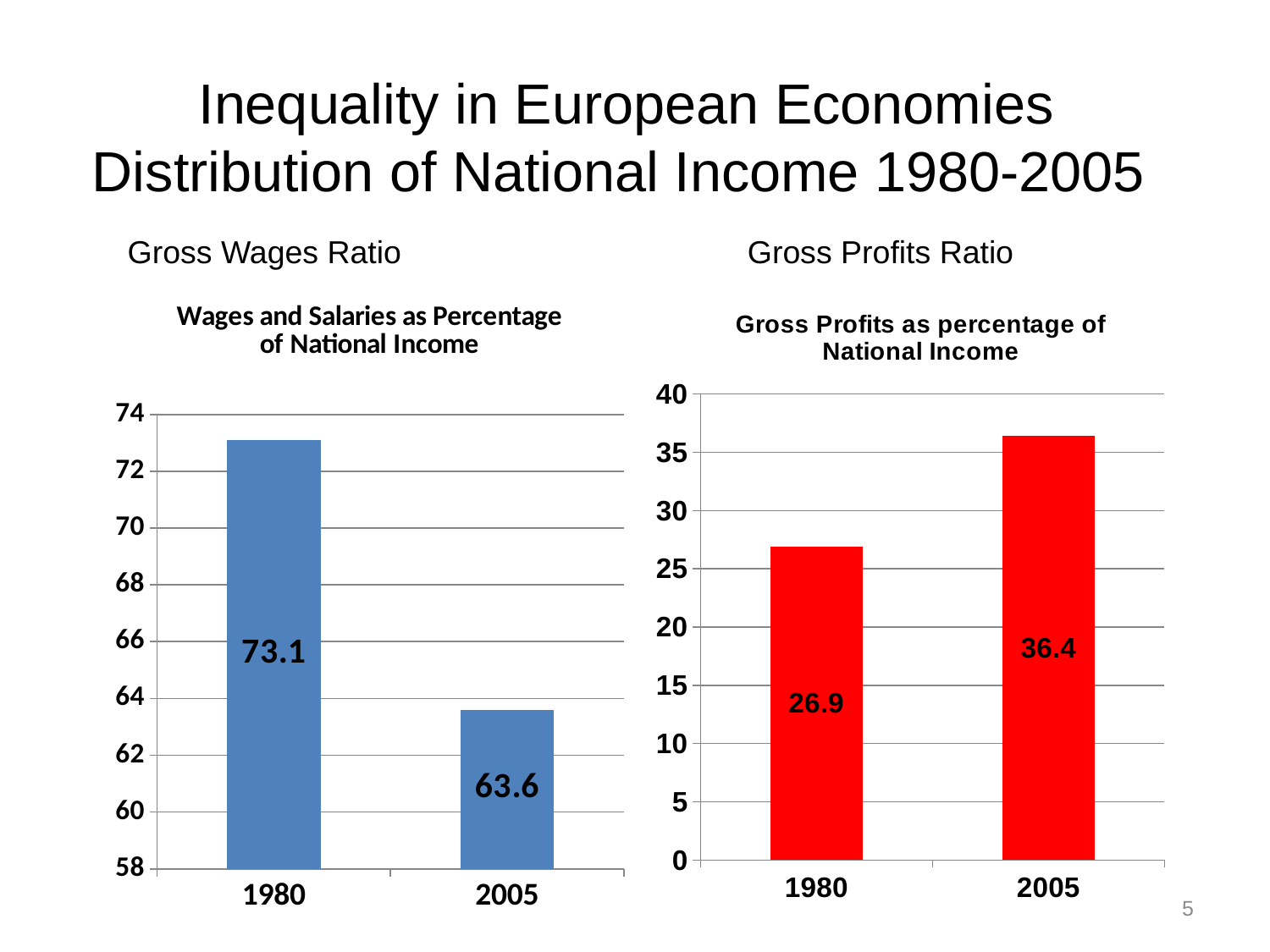
In the 'Wages and Salaries as Percentage of National Income' chart, what is the difference between the 1980 and 2005 values? 9.5 In the 'Gross Profits as percentage of National Income' chart, what is the difference between the 2005 and 1980 values? 9.5 In the 'Gross Profits as percentage of National Income' chart, is the value for 2005 greater or less than 35? greater In the 'Gross Profits as percentage of National Income' chart, which year has the lower value? 1980 What kind of chart is the 'Gross Profits as percentage of National Income' chart? bar chart In the 'Wages and Salaries as Percentage of National Income' chart, which year has the higher value? 1980 In the 'Gross Profits as percentage of National Income' chart, what is the value for 1980? 26.9 In the 'Wages and Salaries as Percentage of National Income' chart, what is the value for 2005? 63.6 In the 'Wages and Salaries as Percentage of National Income' chart, what is the value for 1980? 73.1 In the 'Wages and Salaries as Percentage of National Income' chart, do the values rise or fall from 1980 to 2005? fall How many bars are shown in the 'Wages and Salaries as Percentage of National Income' chart? 2 In the 'Gross Profits as percentage of National Income' chart, what is the value for 2005? 36.4